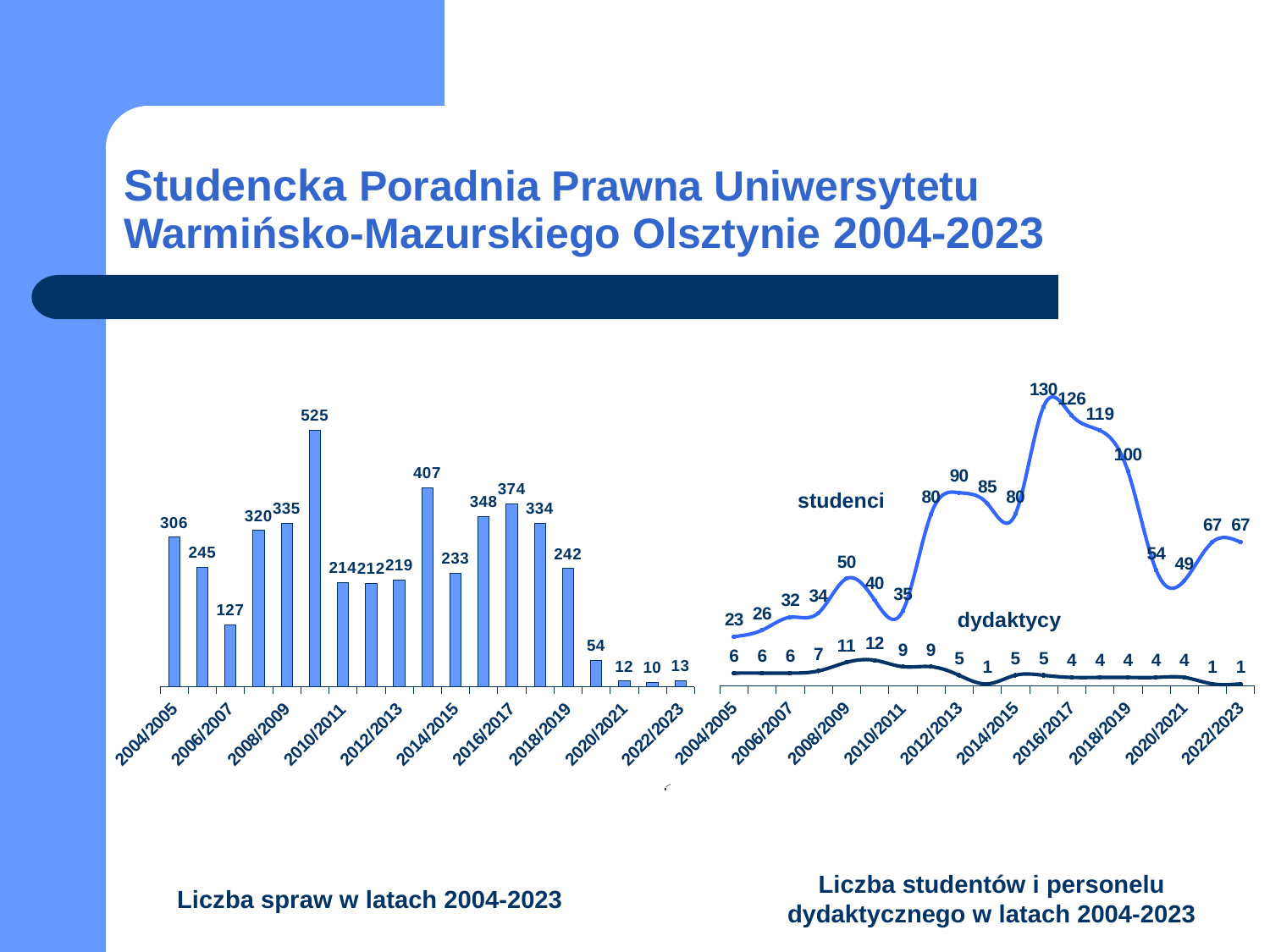
In the chart 'Liczba studentów i personelu dydaktycznego w latach 2004-2023', what is the highest value of the studenci series? 130 In the chart 'Liczba spraw w latach 2004-2023', how many bars are plotted? 19 In the chart 'Liczba studentów i personelu dydaktycznego w latach 2004-2023', which is larger for 2022/2023: studenci or dydaktycy? studenci In the chart 'Liczba spraw w latach 2004-2023', what is the value for 2006/2007? 127 What type of chart is 'Liczba spraw w latach 2004-2023'? bar chart In the chart 'Liczba spraw w latach 2004-2023', what is the value for 2004/2005? 306 In the chart 'Liczba spraw w latach 2004-2023', what is the lowest value shown? 10 In the chart 'Liczba studentów i personelu dydaktycznego w latach 2004-2023', what is the value of studenci for 2016/2017? 126 In the chart 'Liczba spraw w latach 2004-2023', what is the difference between the values for 2016/2017 and 2018/2019? 132 In the chart 'Liczba studentów i personelu dydaktycznego w latach 2004-2023', how many series are plotted? 2 In the chart 'Liczba studentów i personelu dydaktycznego w latach 2004-2023', what is the value of dydaktycy for 2008/2009? 11 In the chart 'Liczba spraw w latach 2004-2023', what is the highest value shown? 525